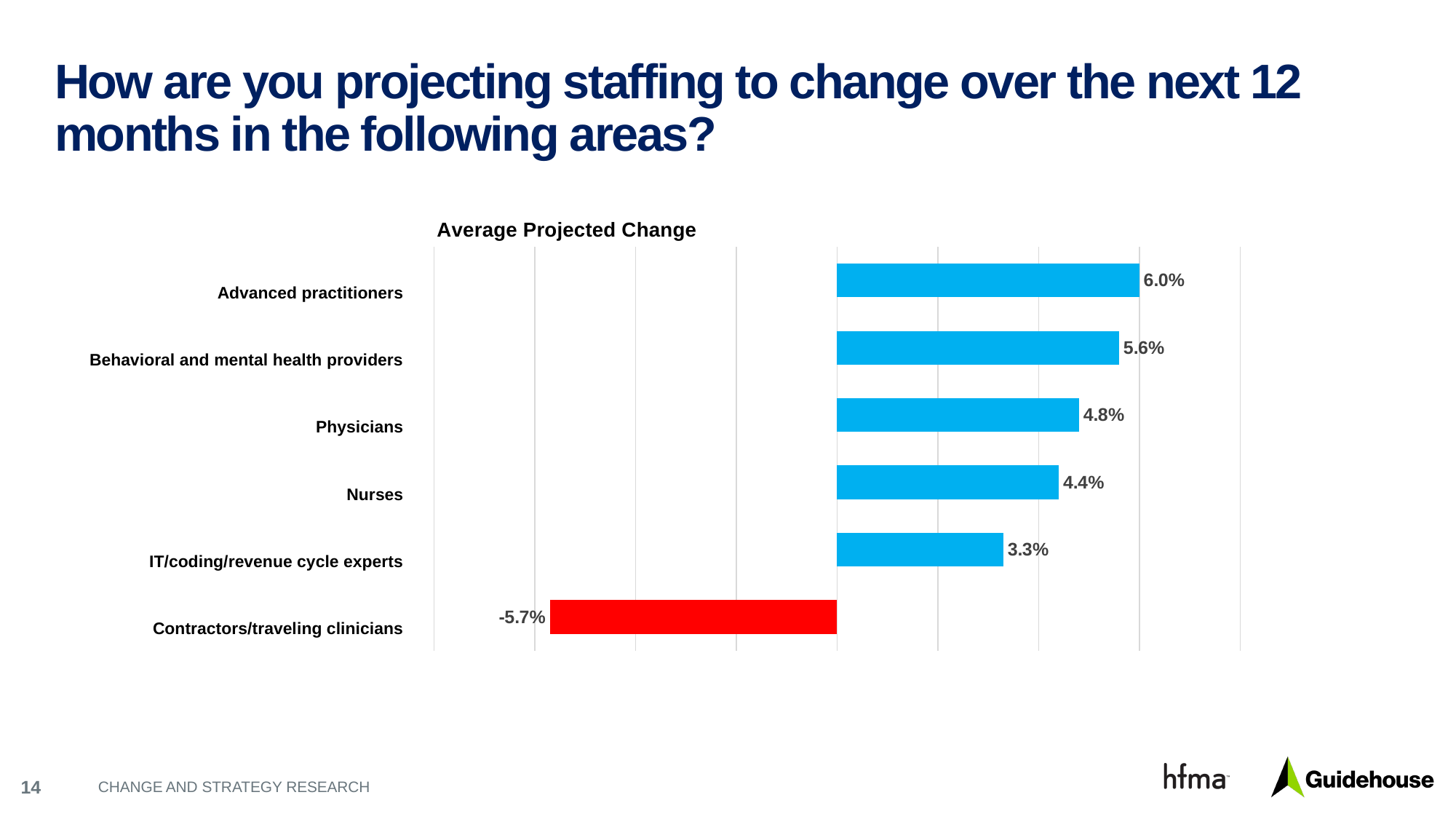
What is the average projected change for Nurses? 4.4% What is the average projected change for IT/coding/revenue cycle experts? 3.3% What is the title of the chart? Average Projected Change What kind of chart is shown on the slide? Bar chart What is the average projected change for Advanced practitioners? 6.0% Which category has the highest average projected change? Advanced practitioners What is the difference between the average projected change for Advanced practitioners and Physicians? 1.2% How many categories are shown in the chart? 6 Which category has the lowest average projected change? Contractors/traveling clinicians Which has a larger average projected change, Behavioral and mental health providers or Nurses? Behavioral and mental health providers Which category's bar is coloured red? Contractors/traveling clinicians What is the average projected change for Contractors/traveling clinicians? -5.7%